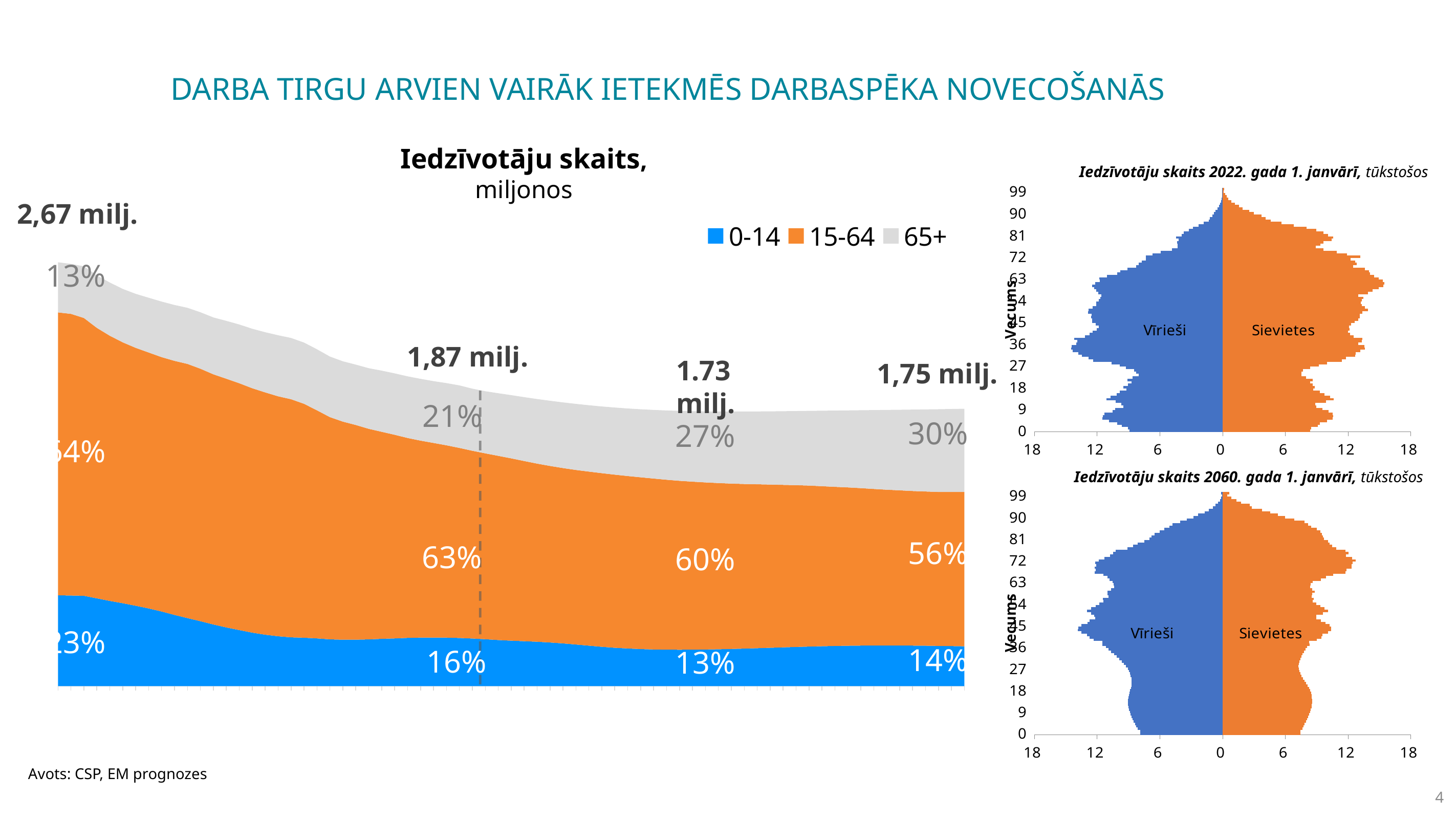
On the chart titled 'Iedzīvotāju skaits, miljonos', what are the three legend entries? 0-14, 15-64, 65+ On the chart titled 'Iedzīvotāju skaits, miljonos', by how many percentage points does the 15-64 share at the leftmost point (64%) exceed the share at the rightmost point (56%)? 8 percentage points On the chart titled 'Iedzīvotāju skaits, miljonos', what share does the 15-64 group have at the point marked 1.73 milj.? 60% On the chart titled 'Iedzīvotāju skaits, miljonos', does the share of the 65+ group rise or fall from left to right? Rise On the chart titled 'Iedzīvotāju skaits 2060. gada 1. janvārī, tūkstošos', what are the two groups shown on the left and right sides? Vīrieši and Sievietes What kind of chart is the chart titled 'Iedzīvotāju skaits, miljonos'? Stacked area chart What kind of chart is the chart titled 'Iedzīvotāju skaits 2022. gada 1. janvārī, tūkstošos'? Bar chart (population pyramid) On the chart titled 'Iedzīvotāju skaits, miljonos', what share does the 0-14 group have at the rightmost point (1,75 milj.)? 14% On the chart titled 'Iedzīvotāju skaits, miljonos', what share does the 65+ group have at the point marked by the dashed line (1,87 milj.)? 21% On the chart titled 'Iedzīvotāju skaits, miljonos', how many series does the legend list? 3 On the chart titled 'Iedzīvotāju skaits, miljonos', which is larger: the 0-14 share at the dashed line (16%) or at the point marked 1.73 milj. (13%)? 16% at the dashed line On the chart titled 'Iedzīvotāju skaits, miljonos', what is the total population shown at the leftmost point? 2,67 milj.